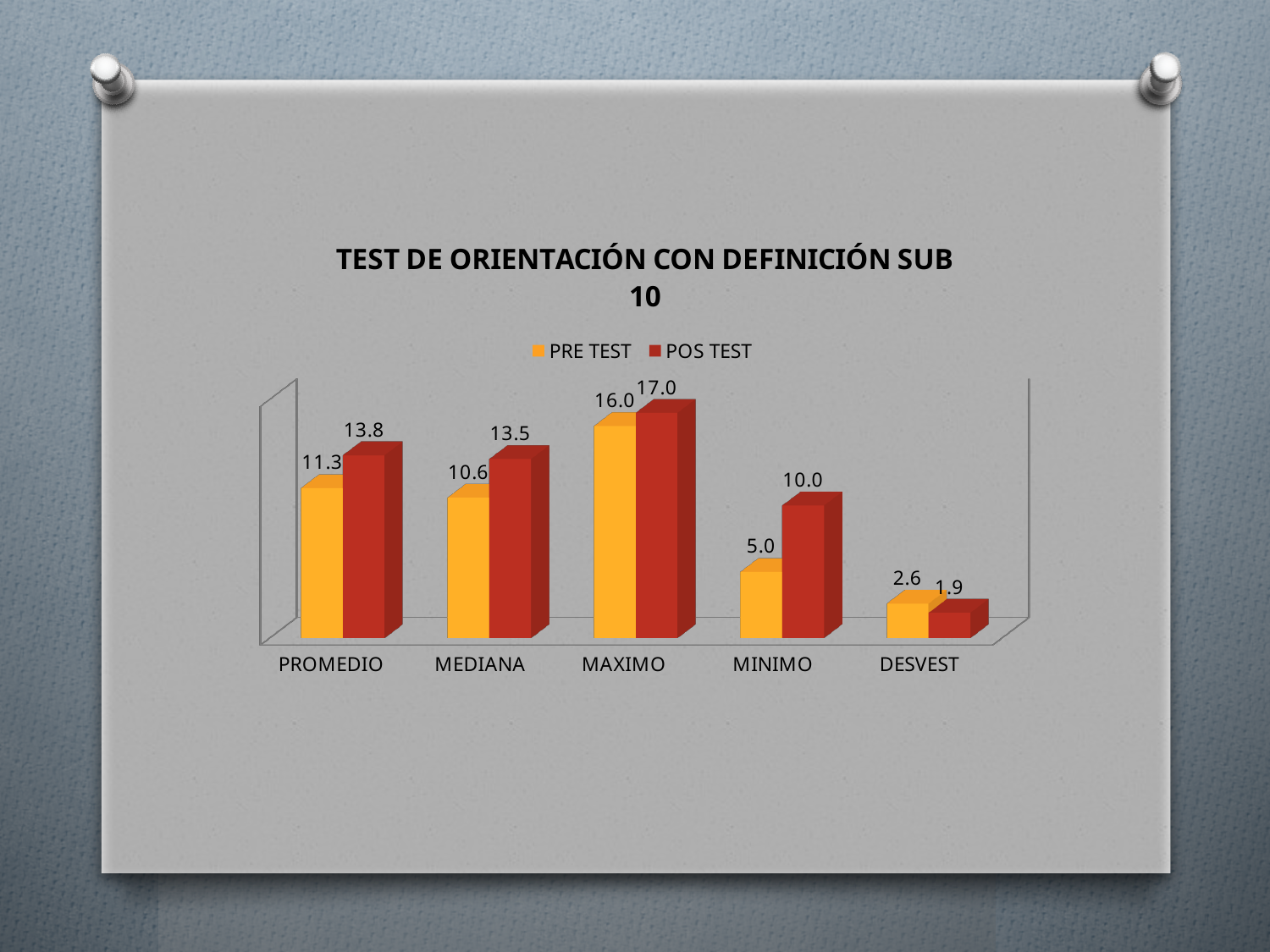
What kind of chart is shown on the slide? Bar chart What is the POS TEST value for MINIMO? 10.0 For DESVEST, which is larger, the PRE TEST or the POS TEST value? PRE TEST What is the difference between the POS TEST and PRE TEST values for PROMEDIO? 2.5 How many categories are shown on the x axis? 5 Which category has the highest POS TEST value? MAXIMO What is the POS TEST value for MEDIANA? 13.5 What is the difference between the POS TEST and PRE TEST values for MINIMO? 5.0 What is the PRE TEST value for PROMEDIO? 11.3 Which category has the lowest PRE TEST value? DESVEST What is the PRE TEST value for DESVEST? 2.6 How many series does the legend list? 2